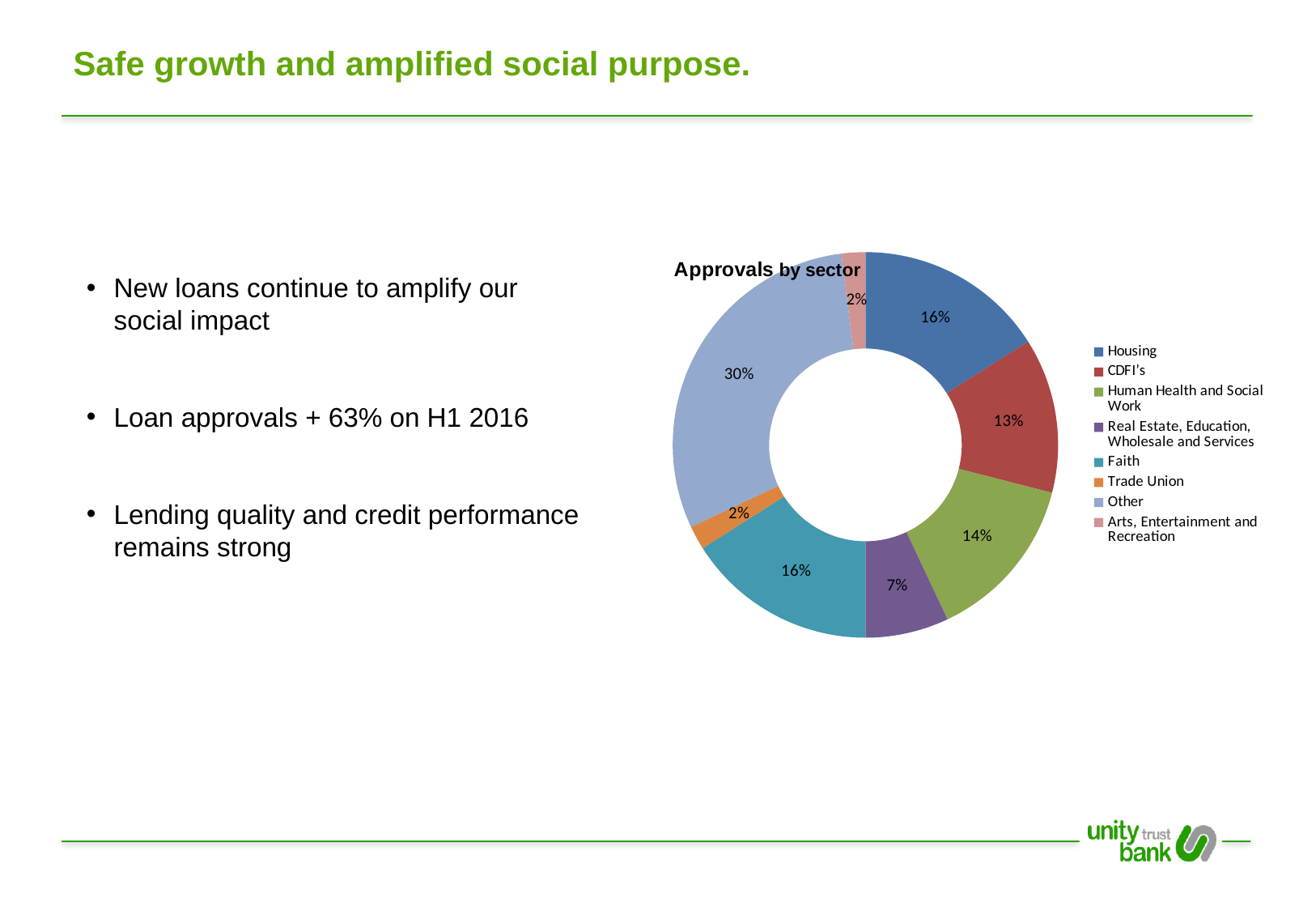
Which has a larger share of approvals, CDFI's or Human Health and Social Work? Human Health and Social Work What share of approvals by sector is Faith? 16% What share of approvals by sector is CDFI's? 13% What share of approvals by sector is Housing? 16% How many sectors does the legend list? 8 What kind of chart is shown on the slide? doughnut chart Which sector has the largest share of approvals? Other What share of approvals by sector is Trade Union? 2% What is the title of the chart? Approvals by sector What share of approvals by sector is Real Estate, Education, Wholesale and Services? 7% What is the difference between the share for Other and the share for Housing? 14% What share of approvals by sector is Human Health and Social Work? 14%